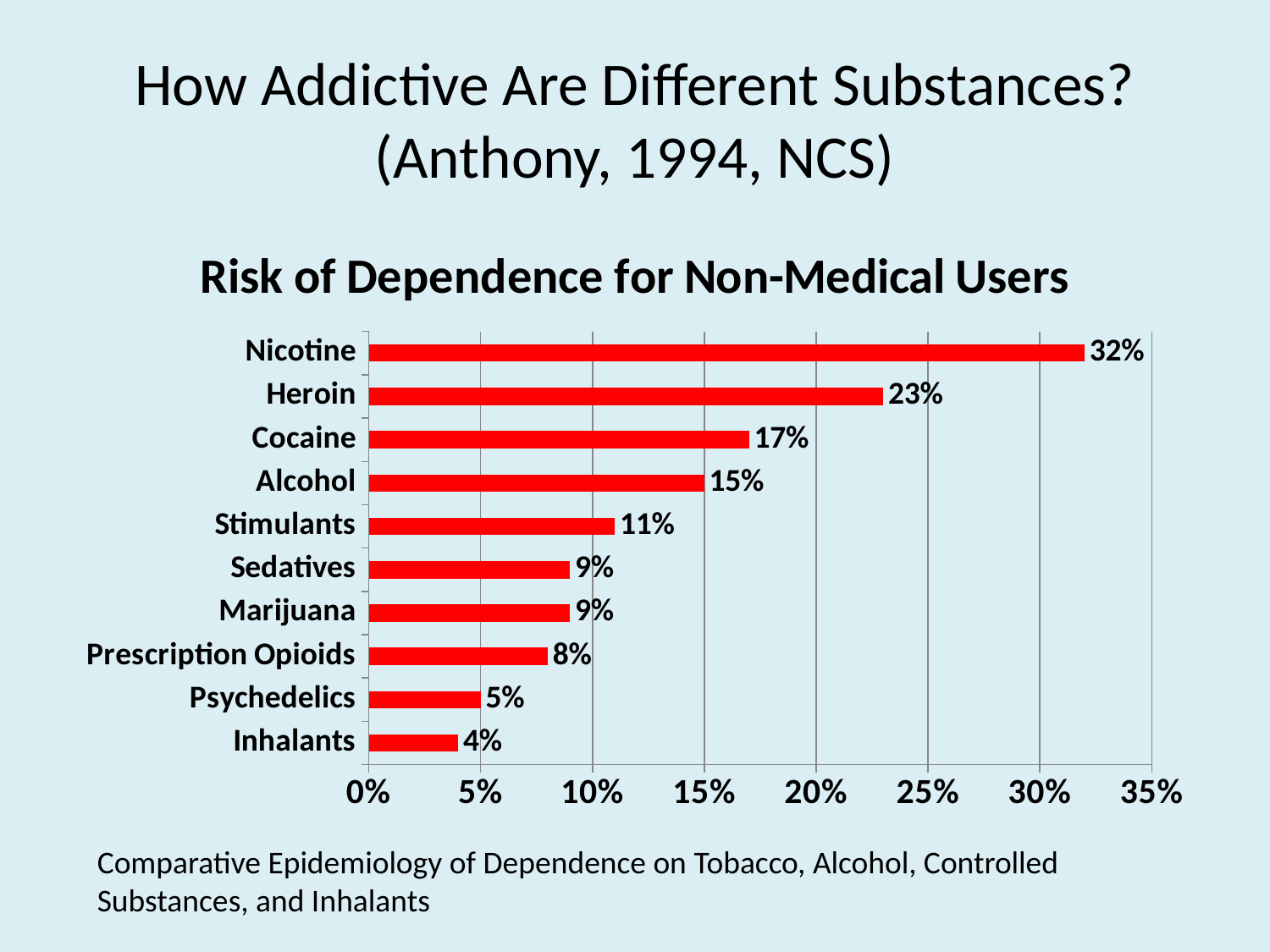
What is the risk of dependence value for Stimulants? 11% Which substance has the highest risk of dependence? Nicotine What is the difference between the values for Cocaine and Alcohol? 2% How many substances are shown in the chart? 10 Which substance has the lowest risk of dependence? Inhalants What is the risk of dependence value for Heroin? 23% What is the difference between the values for Nicotine and Heroin? 9% What is the title of the chart? Risk of Dependence for Non-Medical Users Is the value for Cocaine greater or less than 15%? greater What is the risk of dependence value for Prescription Opioids? 8% What kind of chart is shown on the slide? Bar chart Which has a higher risk of dependence, Alcohol or Stimulants? Alcohol